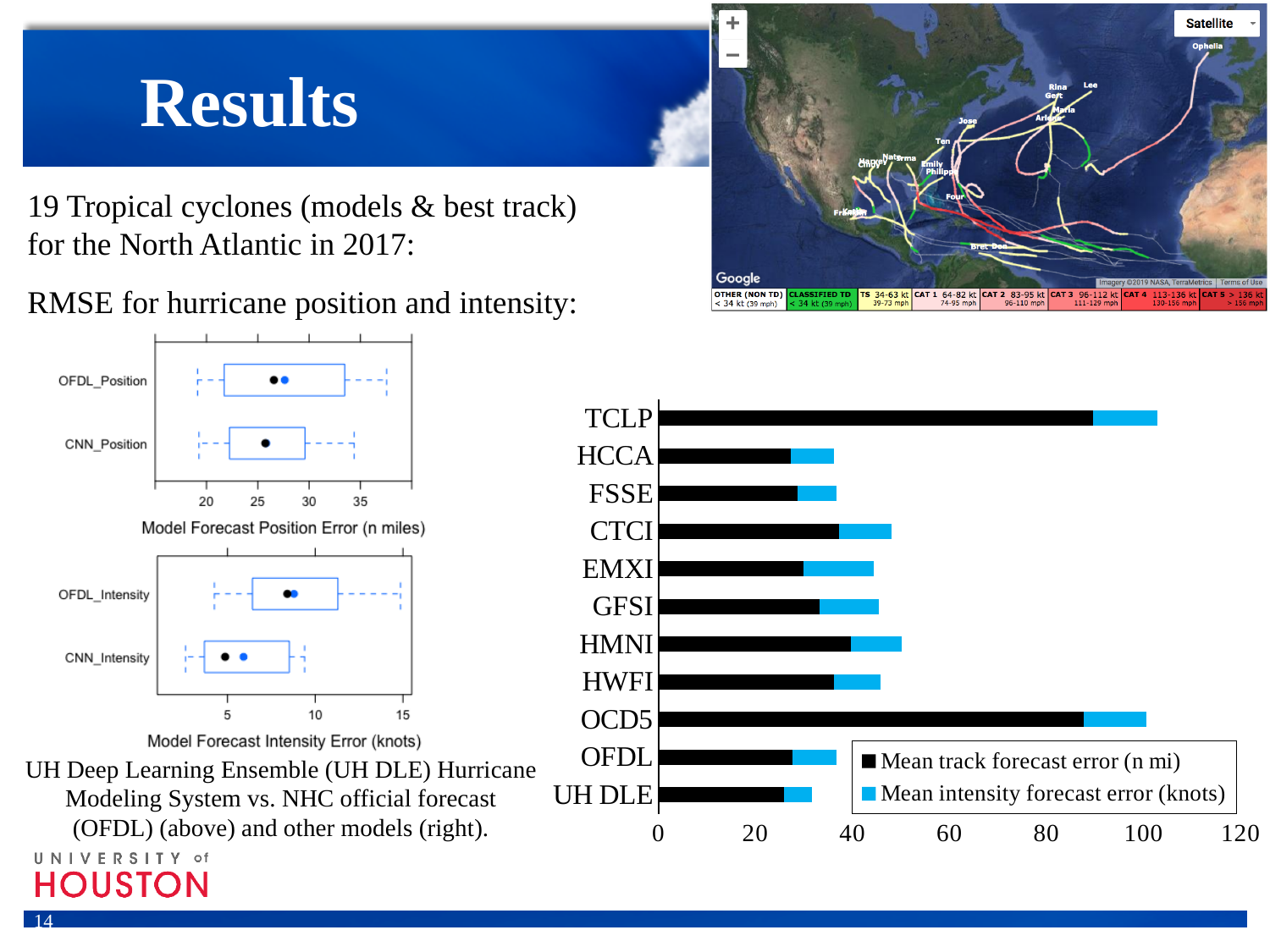
In the bar chart on the right, is the mean track forecast error for TCLP greater or less than 80? greater In the bar chart on the right, is the mean track forecast error for OCD5 greater or less than 60? greater In the bar chart on the right, which has the larger mean track forecast error, HMNI or HCCA? HMNI In the bar chart on the right, which series is shown in black? Mean track forecast error (n mi) In the bar chart on the right, is the total bar length for CTCI greater or less than 60? less In the bar chart on the right, how many series does the legend list? 2 In the bar chart on the right, which series is shown in blue? Mean intensity forecast error (knots) In the bar chart on the right, how many models are listed on the vertical axis? 11 In the bar chart on the right, which model has the shortest total bar? UH DLE In the bar chart on the right, what kind of chart is it? Stacked horizontal bar chart In the bar chart on the right, which has the longer total bar, OCD5 or OFDL? OCD5